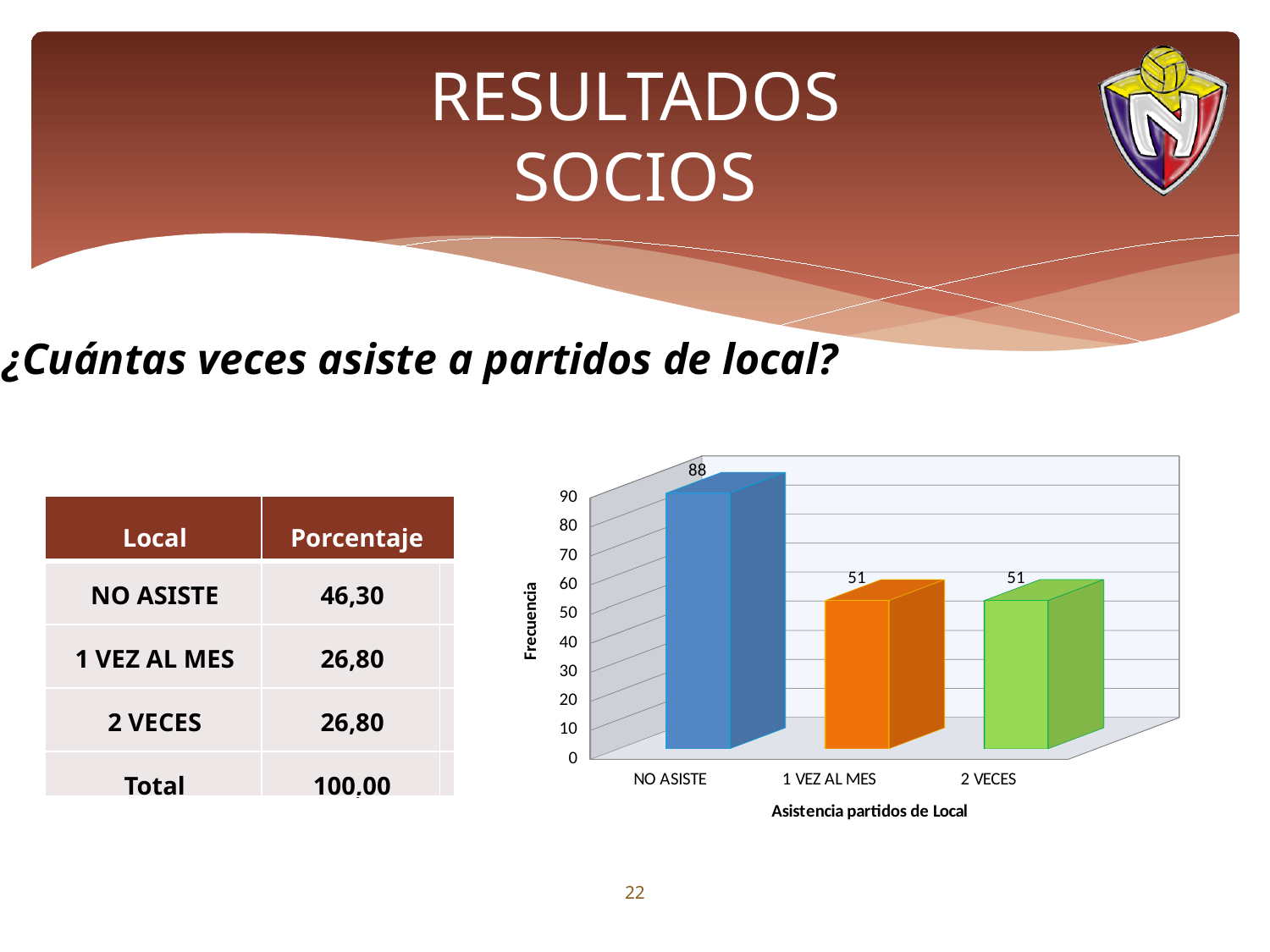
Is the value for NO ASISTE greater or less than 80? greater What is the label of the vertical axis of the chart? Frecuencia Which is larger, the frequency for NO ASISTE or the frequency for 2 VECES? NO ASISTE What is the frequency value for 2 VECES in the chart? 51 What is the frequency value for NO ASISTE in the chart? 88 What is the difference between the frequency for NO ASISTE and the frequency for 1 VEZ AL MES? 37 Which category has the highest frequency in the chart? NO ASISTE How many categories are shown on the x axis of the chart? 3 What kind of chart is shown on the slide? bar chart What is the label of the horizontal axis of the chart? Asistencia partidos de Local Is the value for 2 VECES greater or less than 60? less What is the frequency value for 1 VEZ AL MES in the chart? 51